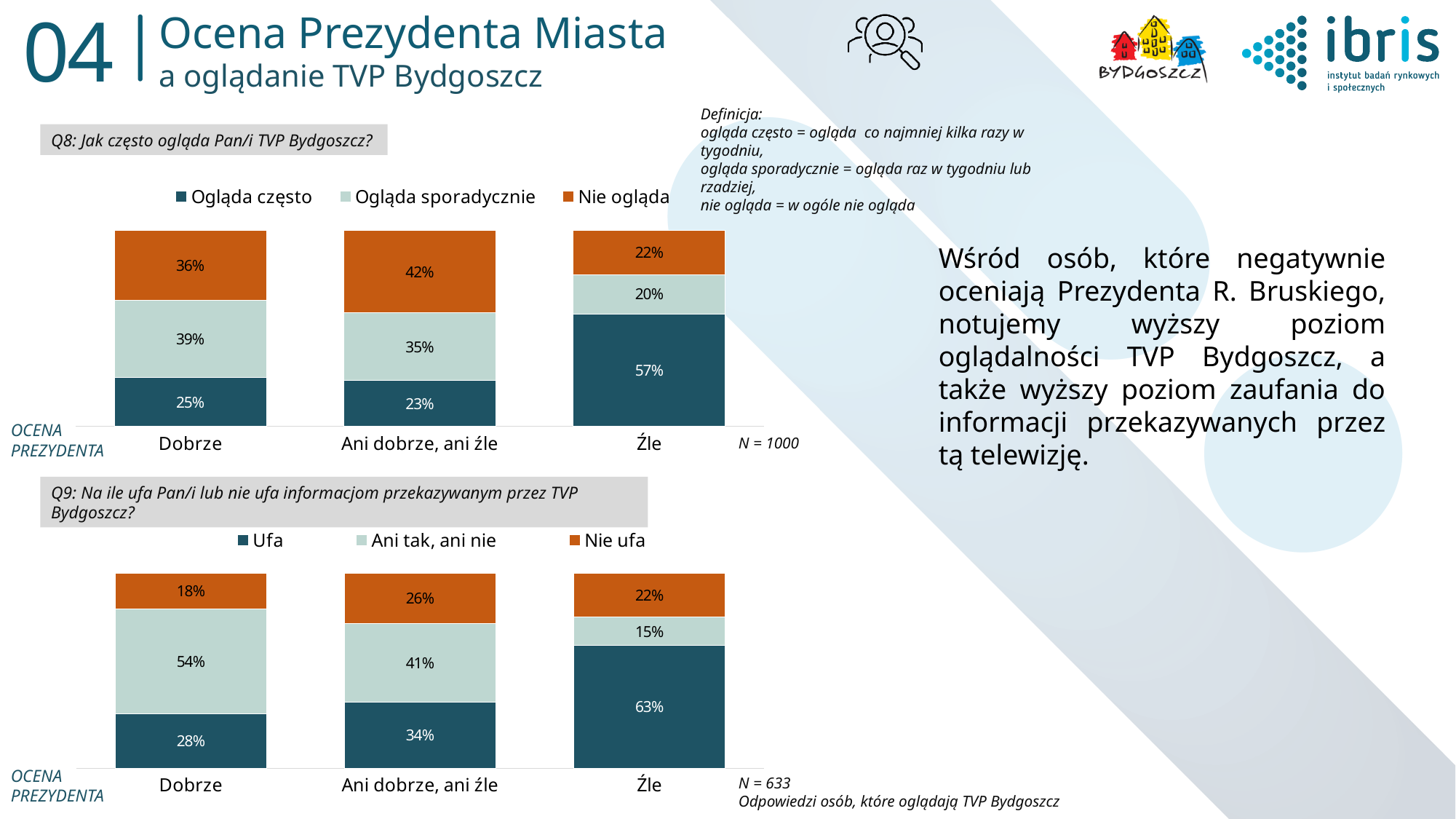
In the bottom chart (Q9), which category has the highest 'Ufa' share? Źle In the bottom chart (Q9), what is the 'Nie ufa' value for the 'Ani dobrze, ani źle' category? 26% In the bottom chart (Q9), what is the total of the stacked bar for 'Źle'? 100% In the top chart (Q8), which category has the lowest 'Nie ogląda' share? Źle How many series does the legend of the top chart (Q8) list? 3 In the top chart (Q8), what is the difference between the 'Ogląda sporadycznie' values for 'Dobrze' and 'Źle'? 19 percentage points In the bottom chart (Q9), which is larger: the 'Ani tak, ani nie' value for 'Dobrze' or for 'Źle'? Dobrze In the top chart (Q8), what percentage of respondents who rate the president 'Źle' watch TVP Bydgoszcz often (Ogląda często)? 57% In the top chart (Q8), what is the 'Nie ogląda' value for the 'Ani dobrze, ani źle' category? 42% In the bottom chart (Q9), what percentage of respondents who rate the president 'Dobrze' trust TVP Bydgoszcz (Ufa)? 28% What type of chart is used for Q9 at the bottom of the slide? Stacked bar chart In the top chart (Q8), which category has the highest 'Ogląda często' share? Źle